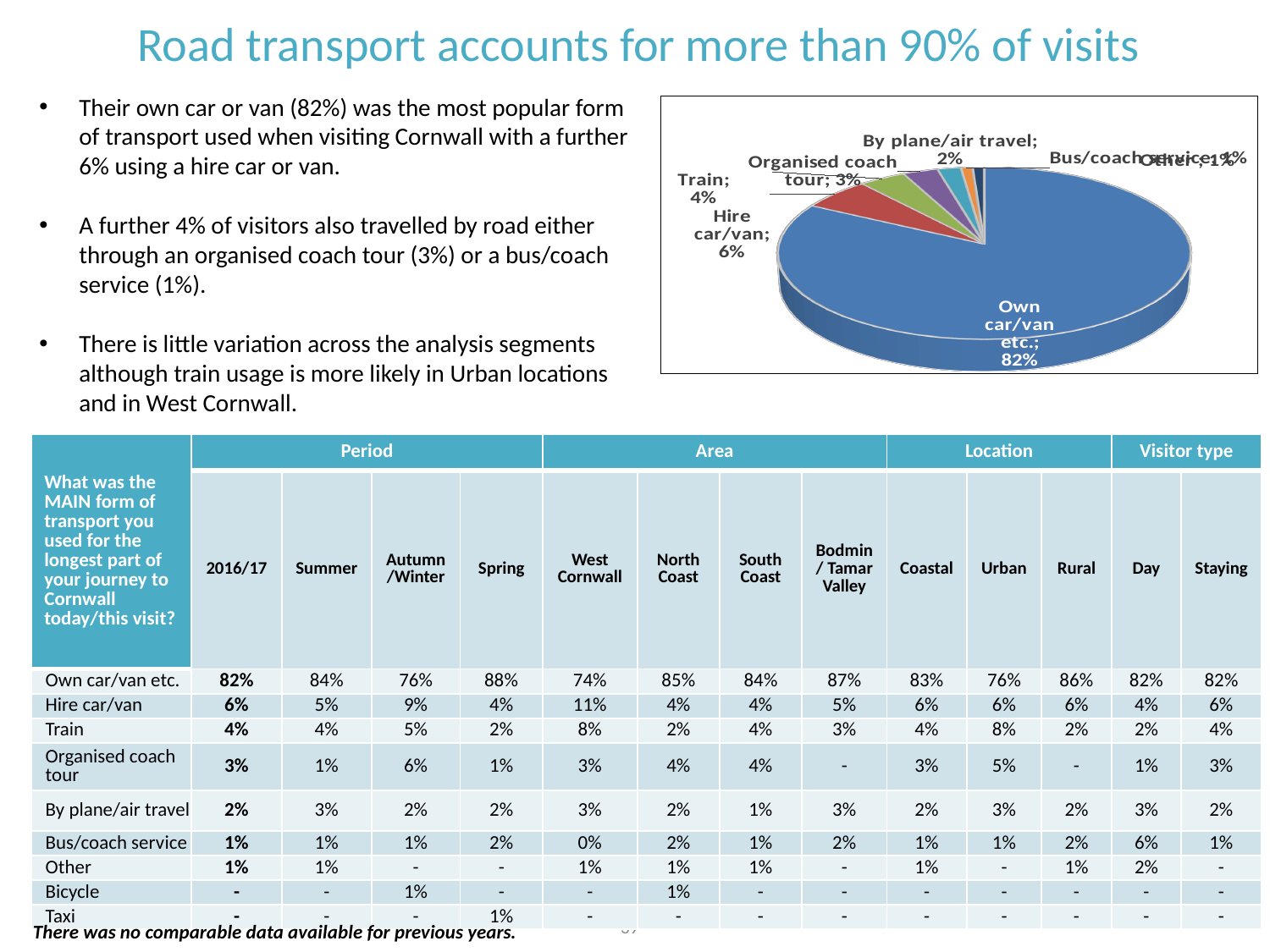
What value is shown for 'Organised coach tour' in the pie chart? 3% What percentage of visits does the 'Own car/van etc.' slice represent in the pie chart? 82% What value is shown for 'By plane/air travel' in the pie chart? 2% What value is shown for 'Train' in the pie chart? 4% In the pie chart, which is larger: 'Train' or 'Organised coach tour'? Train How many slices does the pie chart have? 7 Which category has the largest slice in the pie chart? Own car/van etc. What colour is the largest slice in the pie chart? Blue What value is shown for 'Hire car/van' in the pie chart? 6% What is the difference in percentage points between 'Hire car/van' and 'Train' in the pie chart? 2 percentage points What is the difference in percentage points between 'Own car/van etc.' and 'Hire car/van' in the pie chart? 76 percentage points What kind of chart is shown on the slide? Pie chart